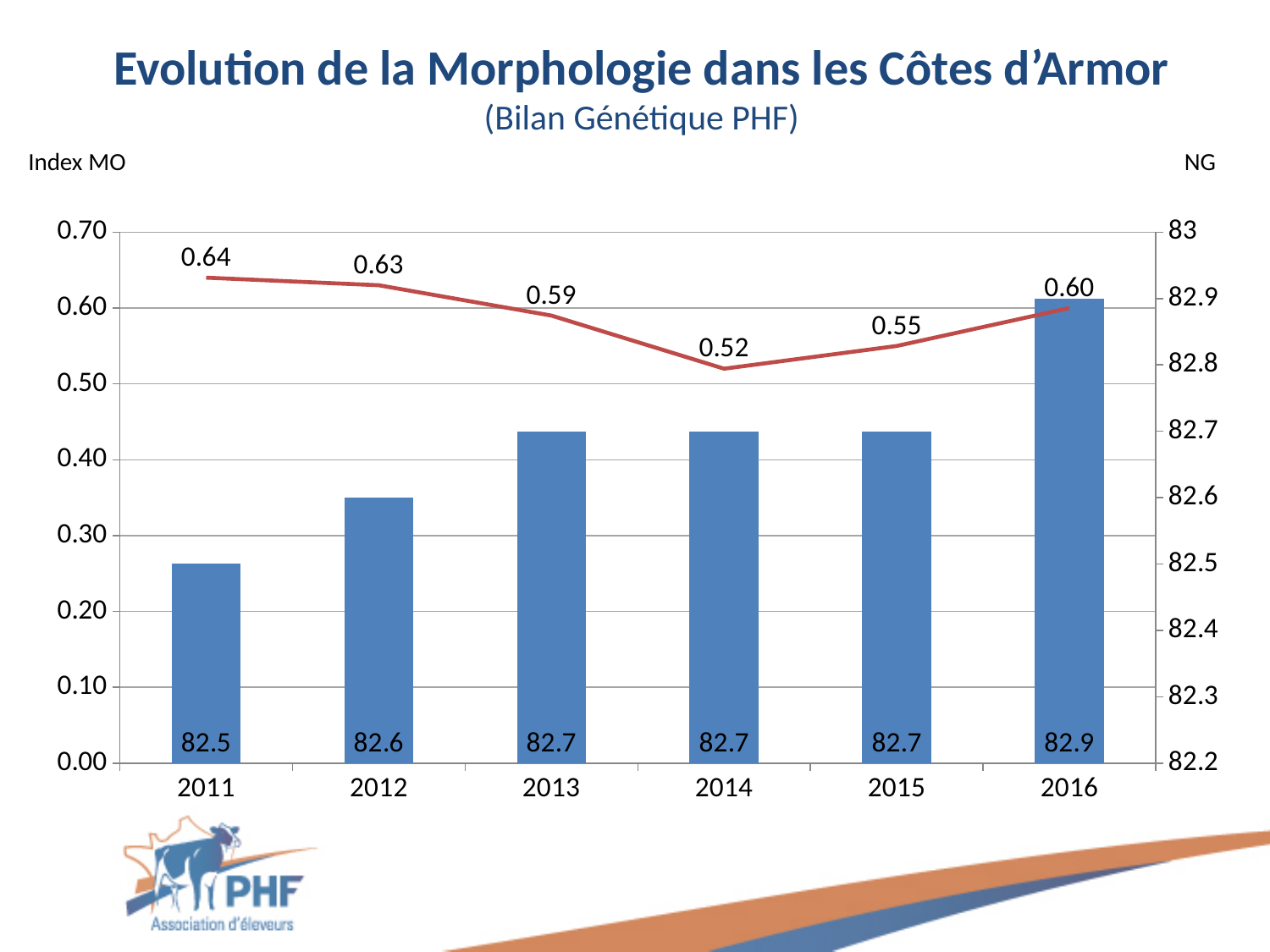
What is the difference between the NG values for 2016 and 2011? 0.4 In which year is the Index MO line at its lowest? 2014 What is the Index MO value for 2011? 0.64 What is the NG value shown on the bar for 2016? 82.9 How many years are shown on the x axis? 6 What is the NG value shown on the bar for 2012? 82.6 In which year is the Index MO line at its highest? 2011 Which is larger, the Index MO value for 2015 or for 2016? 2016 Which year has the tallest NG bar? 2016 What is the difference between the Index MO values for 2011 and 2014? 0.12 Does the Index MO line rise or fall from 2011 to 2014? fall What is the Index MO value for 2014? 0.52